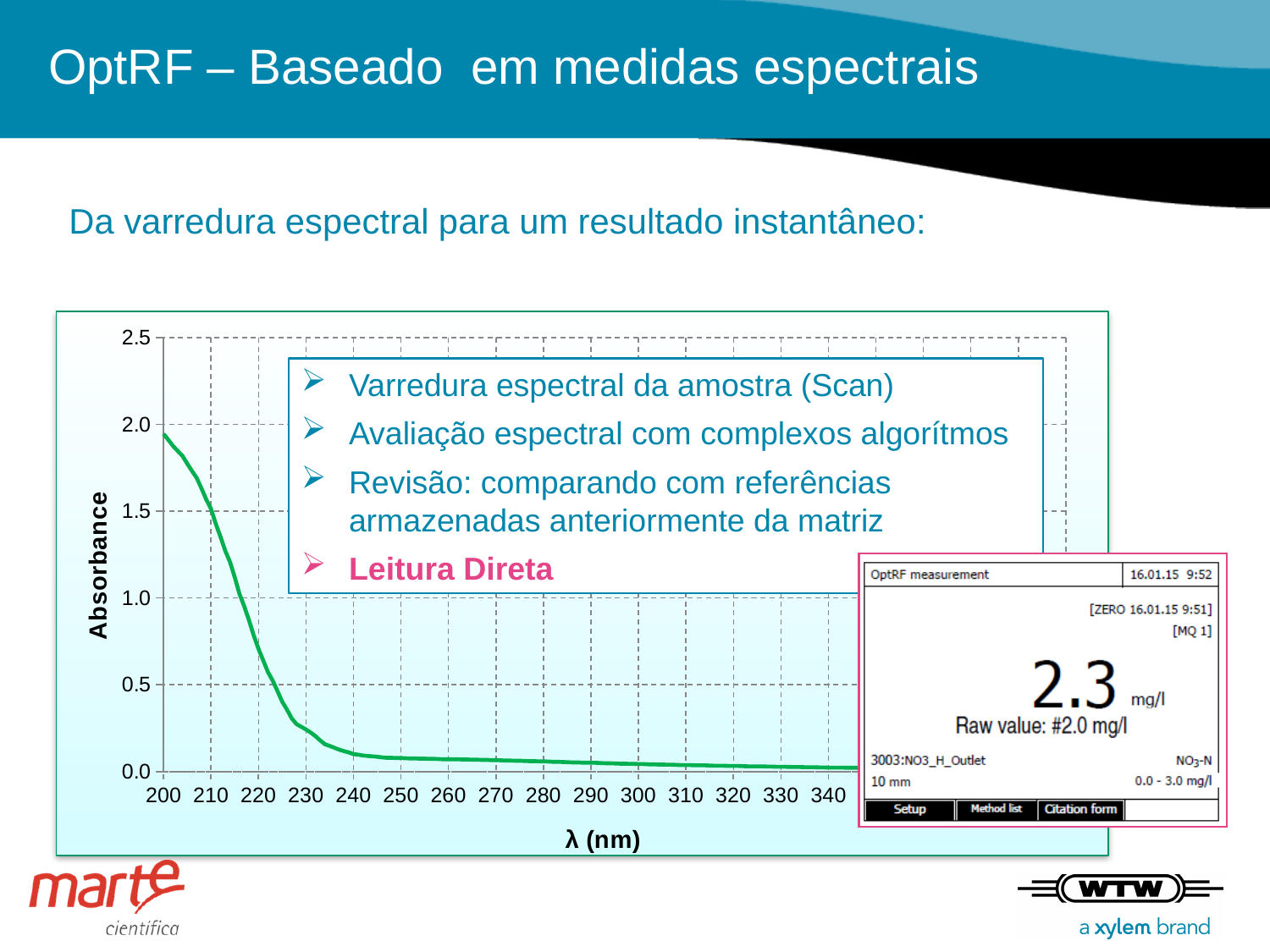
Is the absorbance at 230 nm greater or less than 0.5? less How many lines are plotted on the chart? 1 What is the label of the y axis of the chart? Absorbance Which wavelength has the larger absorbance, 210 nm or 240 nm? 210 nm Is the absorbance at 250 nm greater or less than 0.5? less Does the absorbance rise or fall as the wavelength increases from 200 nm to 340 nm? fall Is the absorbance at 300 nm greater or less than 1.0? less Which wavelength has the larger absorbance, 200 nm or 300 nm? 200 nm What is the label of the x axis of the chart? λ (nm) What kind of chart is shown on the slide? line chart At which wavelength shown on the x axis is the absorbance highest? 200